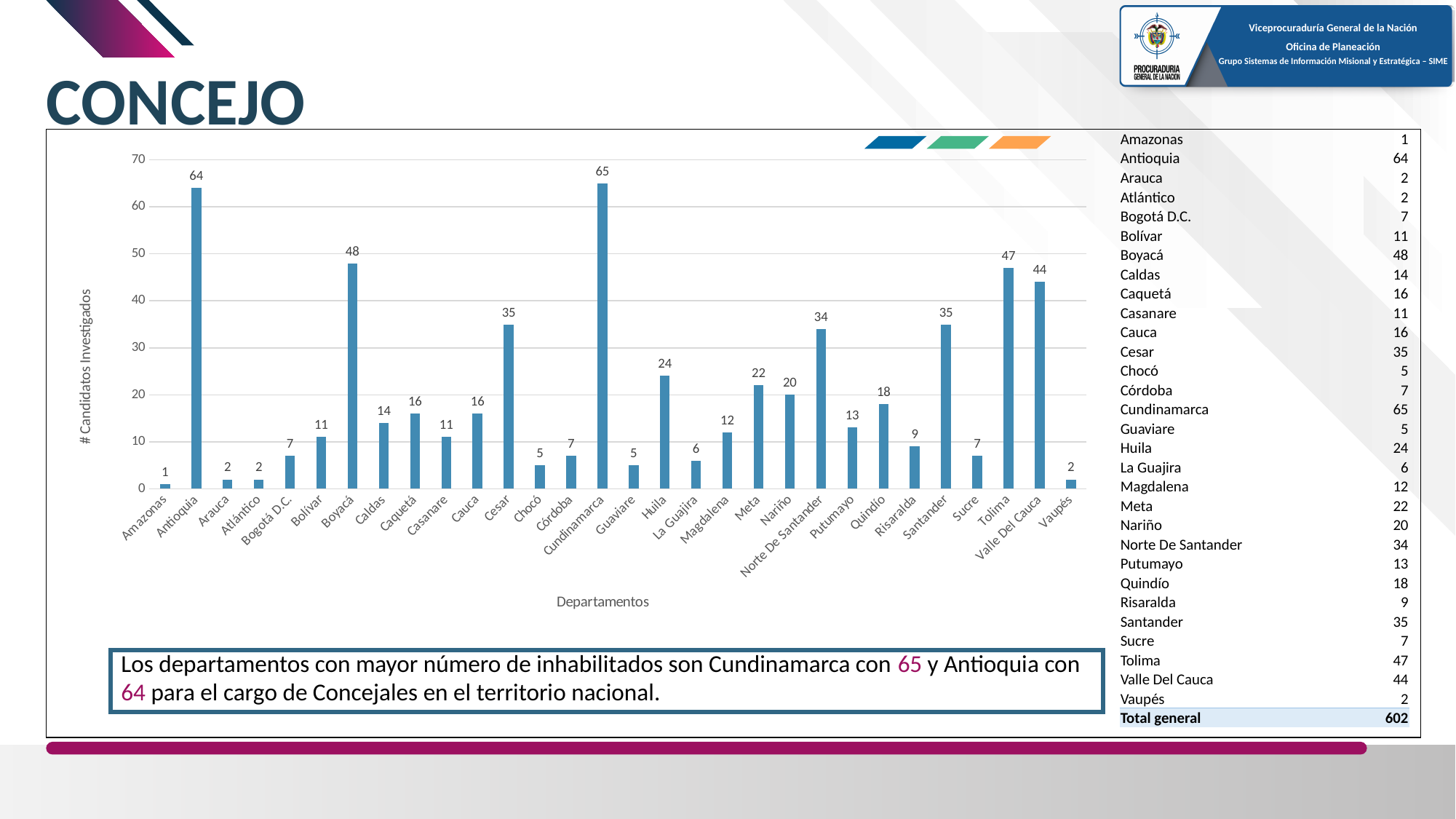
What is the difference between the values for Tolima and Valle Del Cauca? 3 What is the difference between the values for Cundinamarca and Antioquia? 1 Which has a larger value, Huila or Meta? Huila What is the value for Cundinamarca? 65 What is the label of the y axis of the chart? # Candidatos Investigados What is the label of the x axis of the chart? Departamentos What is the value for Norte De Santander? 34 How many departments are shown on the x axis of the chart? 30 What type of chart is shown on the slide? Bar chart Which department has the highest number of candidatos investigados? Cundinamarca What is the value for Boyacá? 48 Which department has the lowest number of candidatos investigados? Amazonas